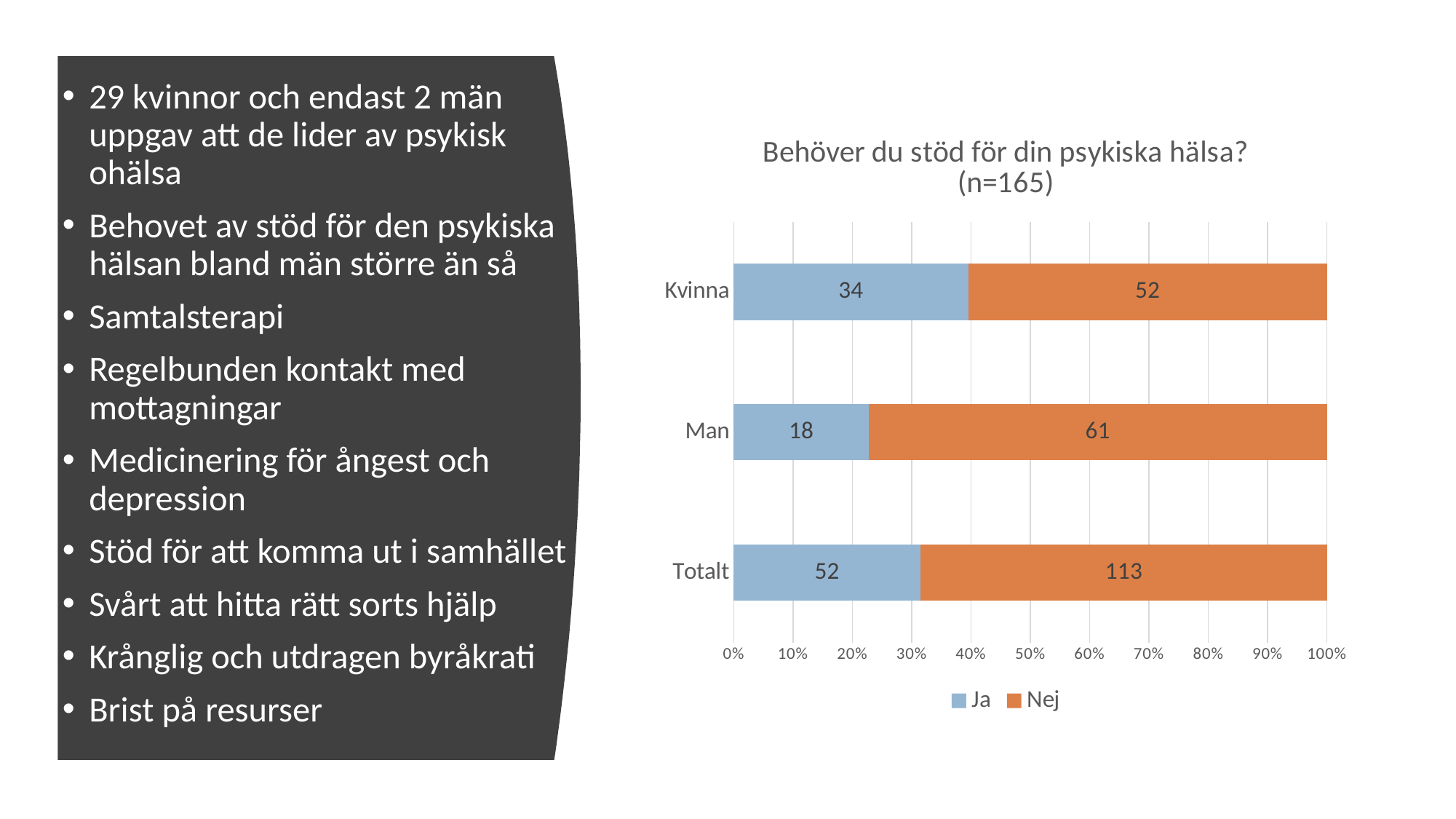
Which is larger, the Ja value for Kvinna or the Ja value for Man? Ja value for Kvinna Is the Ja share of the Man bar greater or less than 20%? greater What is the value for Nej for Totalt? 113 What is the total of the Man bar (Ja plus Nej)? 79 How many series does the legend list? 2 What is the value for Nej for Man? 61 What is the difference between the Nej and Ja values for Kvinna? 18 How many categories are shown on the y axis? 3 What is the value for Ja for Kvinna? 34 Which category has the lowest Ja value? Man What kind of chart is shown? Stacked bar chart Which category has the highest Nej value? Totalt